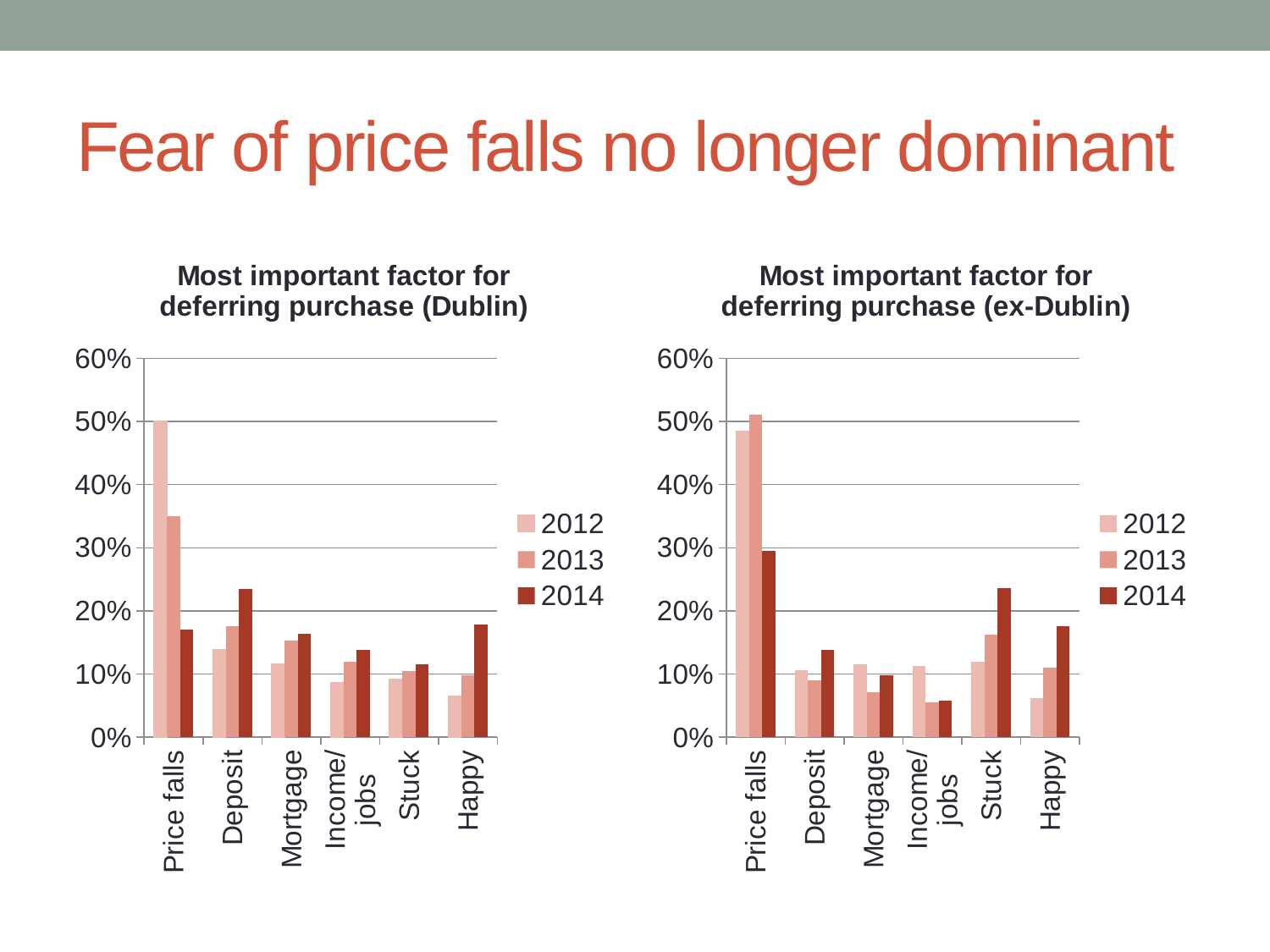
In the 'Most important factor for deferring purchase (ex-Dublin)' chart, which is larger for 2014: Stuck or Deposit? Stuck In the 'Most important factor for deferring purchase (Dublin)' chart, how many series does the legend list? 3 In the 'Most important factor for deferring purchase (Dublin)' chart, how many categories are shown on the x axis? 6 In the 'Most important factor for deferring purchase (ex-Dublin)' chart, is the 2014 value for Stuck greater or less than 20%? greater In the 'Most important factor for deferring purchase (Dublin)' chart, is the 2012 value for Happy greater or less than 10%? less What kind of chart is the 'Most important factor for deferring purchase (Dublin)' chart? Bar chart In the 'Most important factor for deferring purchase (Dublin)' chart, is the 2013 value for Price falls greater or less than 30%? greater In the 'Most important factor for deferring purchase (ex-Dublin)' chart, which category has the lowest value for 2013? Income/jobs In the 'Most important factor for deferring purchase (Dublin)' chart, does the value for Price falls rise or fall from 2012 to 2014? Falls What entries does the legend of the 'Most important factor for deferring purchase (ex-Dublin)' chart list? 2012, 2013, 2014 In the 'Most important factor for deferring purchase (Dublin)' chart, which category has the highest value for 2012? Price falls In the 'Most important factor for deferring purchase (ex-Dublin)' chart, which category has the highest value for 2014? Price falls